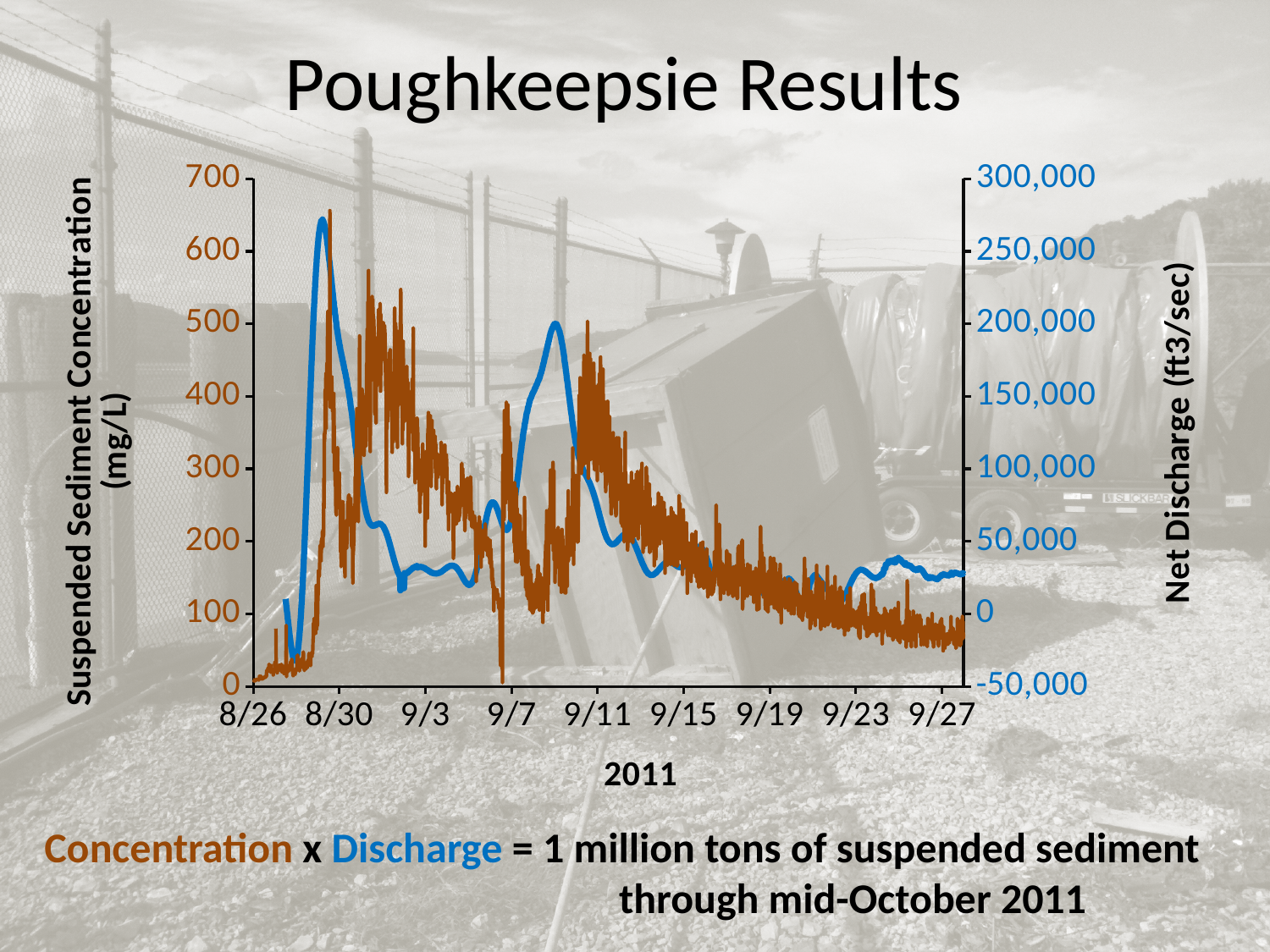
Does the Suspended Sediment Concentration generally rise or fall between 9/11 and 9/27? fall What is the title of the right vertical axis? Net Discharge (ft3/sec) How many date labels are shown along the x axis? 9 Which series reaches its highest peak first, Net Discharge or Suspended Sediment Concentration? Net Discharge How many data series are plotted on the chart? 2 Is the peak value of Suspended Sediment Concentration greater or less than 600? greater Is the Suspended Sediment Concentration at 9/27 greater or less than 100? less What is the title of the left vertical axis? Suspended Sediment Concentration (mg/L) Is the peak value of Net Discharge greater or less than 250,000? greater What kind of chart is shown on the slide? line chart What is the lowest tick value shown on the right vertical axis? -50,000 What is the highest tick value shown on the left vertical axis? 700